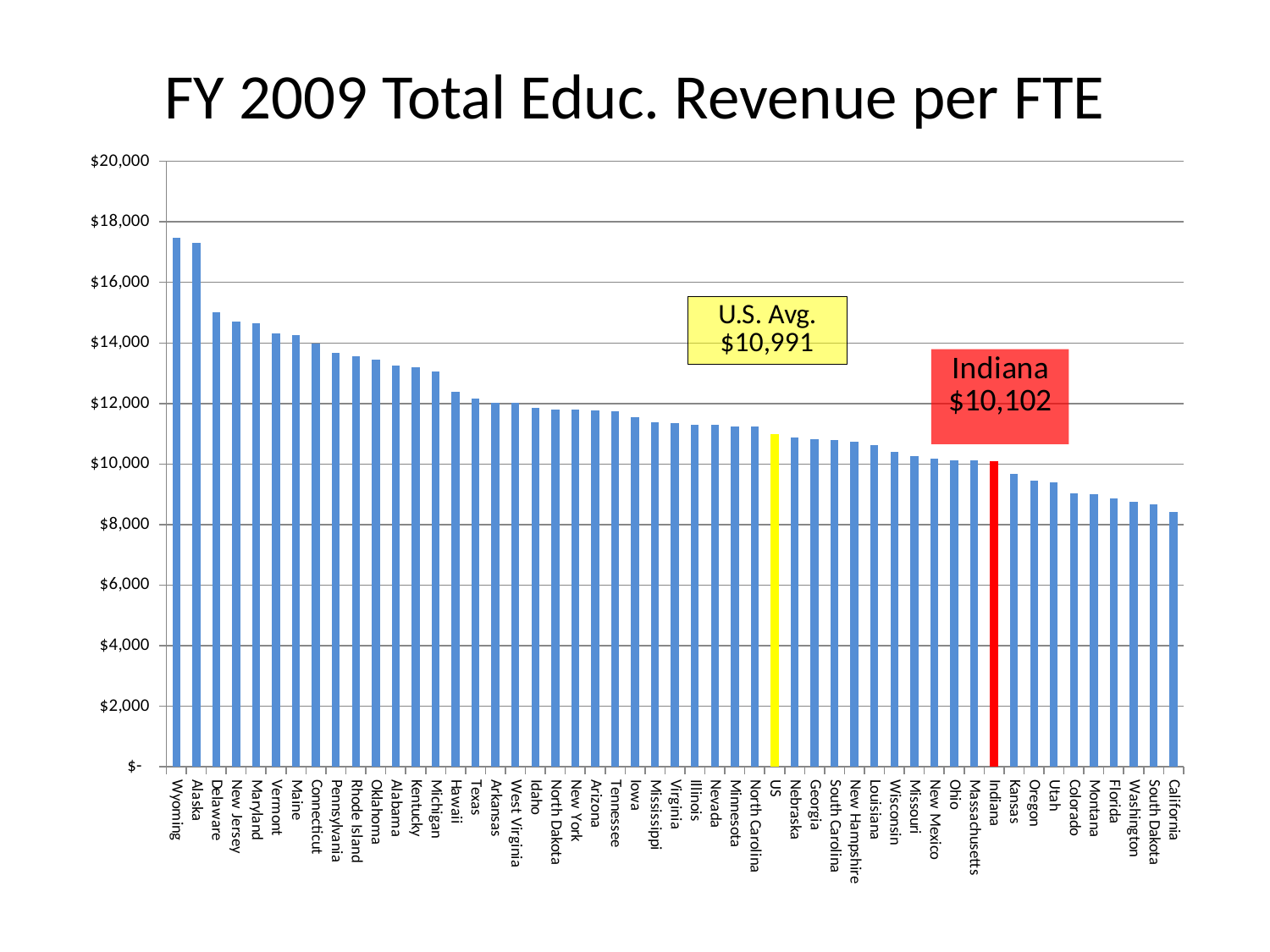
What is the U.S. average total education revenue per FTE shown on the chart? $10,991 What kind of chart is shown on the slide? bar chart How much lower is Indiana's value than the U.S. average? $889 Is the value for Wyoming greater or less than $16,000? greater What colour is the bar for Indiana? red Is the value for California greater or less than $10,000? less Which state has the highest total education revenue per FTE? Wyoming Which state has the lowest total education revenue per FTE? California Do the bar values rise or fall moving from left to right along the x axis? fall What is the title of the chart? FY 2009 Total Educ. Revenue per FTE Which has a higher value, Delaware or California? Delaware What is Indiana's total education revenue per FTE shown on the chart? $10,102